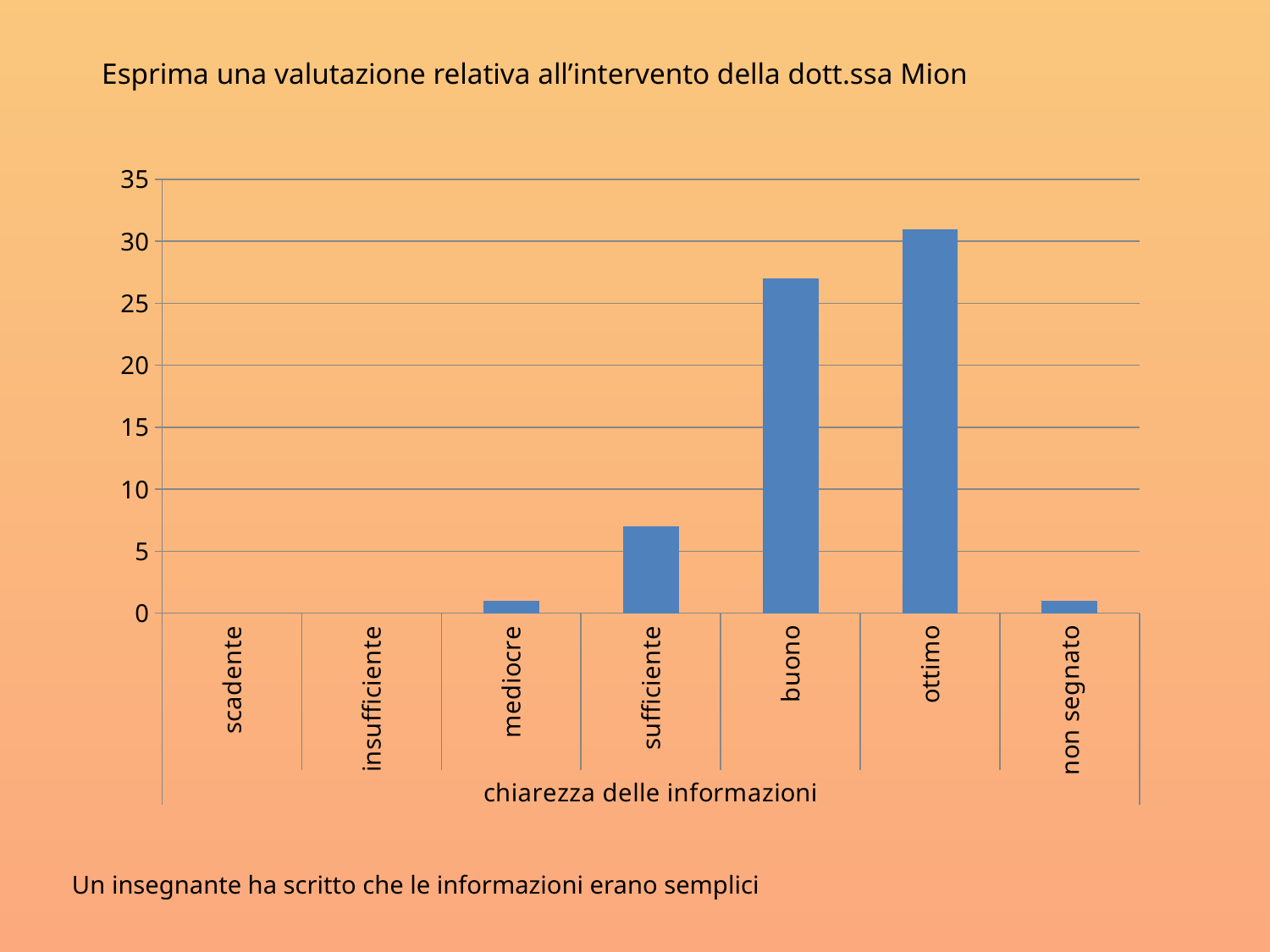
Is the value for buono greater or less than 30? less What is the label shown under the x axis of the chart? chiarezza delle informazioni Which category has the highest bar in the chart? ottimo Is the value for sufficiente greater or less than 5? greater What kind of chart is shown on the slide? bar chart Is the value for buono greater or less than 25? greater What is the value for scadente in the chart? 0 Which is larger, the value for buono or the value for ottimo? ottimo Which is larger, the value for sufficiente or the value for buono? buono How many categories are shown on the x axis of the chart? 7